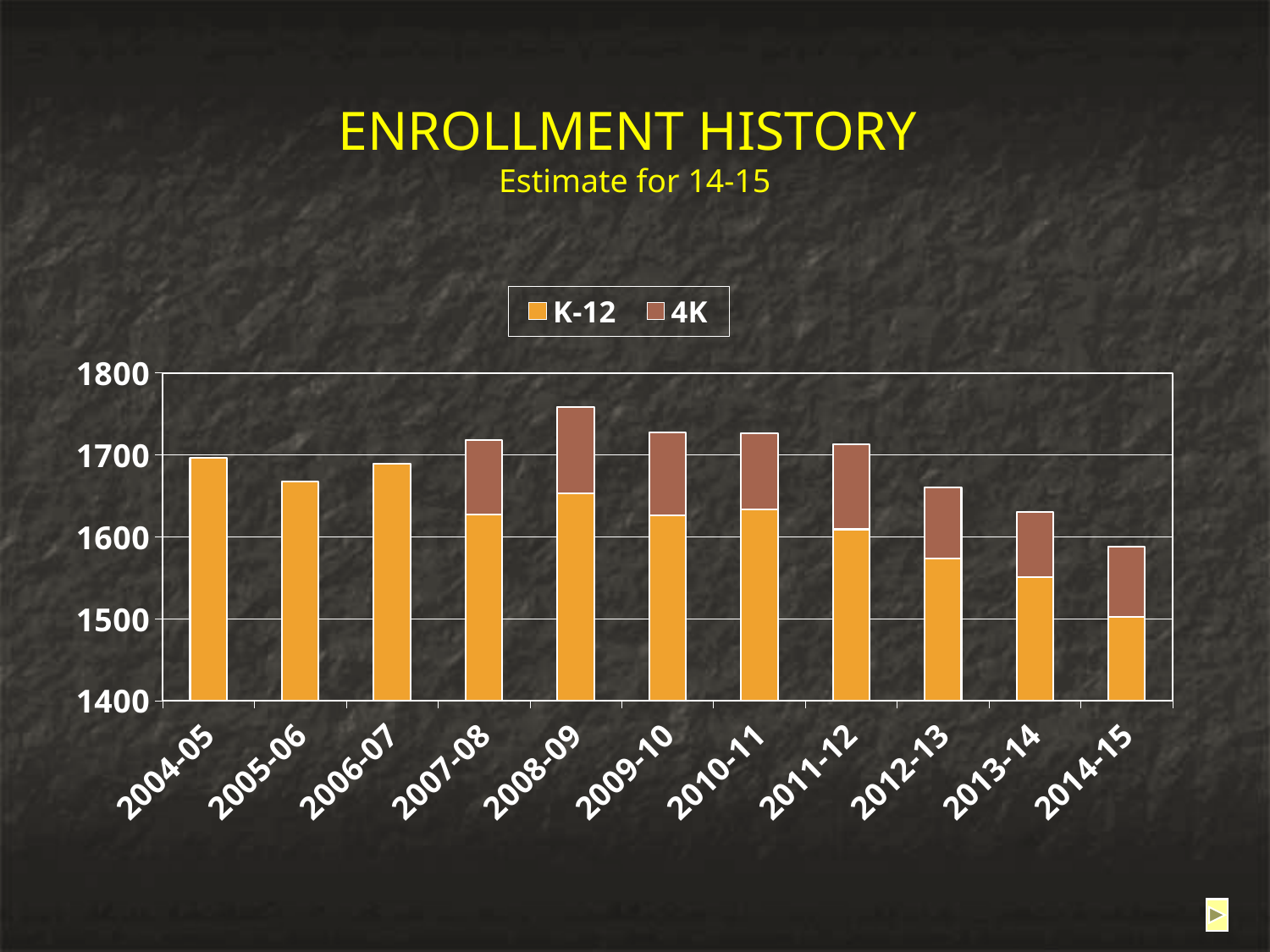
Which school year has the lowest total enrollment (K-12 plus 4K)? 2014-15 Which school year has the highest total enrollment (K-12 plus 4K)? 2008-09 Which is larger, the K-12 enrollment for 2012-13 or for 2013-14? 2012-13 Is the K-12 value for 2005-06 greater or less than 1700? less Is the total enrollment for 2008-09 greater or less than 1700? greater How many school years are shown on the x axis? 11 Which school years show no 4K enrollment segment? 2004-05, 2005-06, 2006-07 How many series does the legend list? 2 From 2008-09 to 2014-15, does total enrollment rise or fall? Fall What kind of chart is shown on the slide? Stacked bar chart Which school year has the lowest K-12 enrollment? 2014-15 Is the K-12 value for 2012-13 greater or less than 1600? less